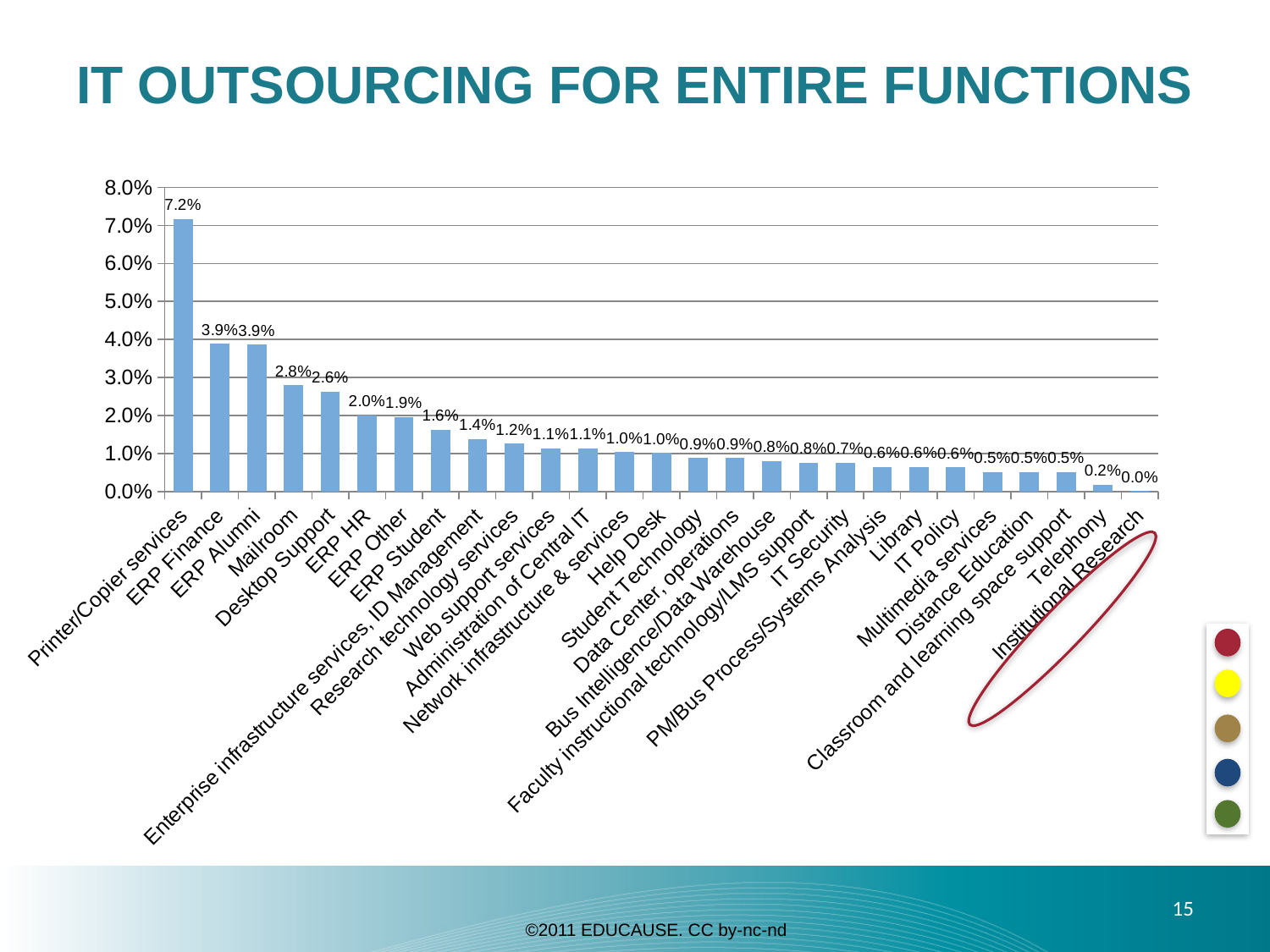
What is the difference between the values for Printer/Copier services and ERP Finance? 3.3% Is the value for ERP Alumni greater or less than 3.0%? greater Which category has the lowest value? Institutional Research Which is larger, the value for Desktop Support or the value for ERP HR? Desktop Support How many categories are shown on the x axis? 27 What kind of chart is shown on the slide? bar chart What is the value for Telephony? 0.2% What is the value for Printer/Copier services? 7.2% What is the value for Mailroom? 2.8% Which category has the highest value? Printer/Copier services Do the values rise or fall moving from left to right along the x axis? fall What is the value for Help Desk? 1.0%